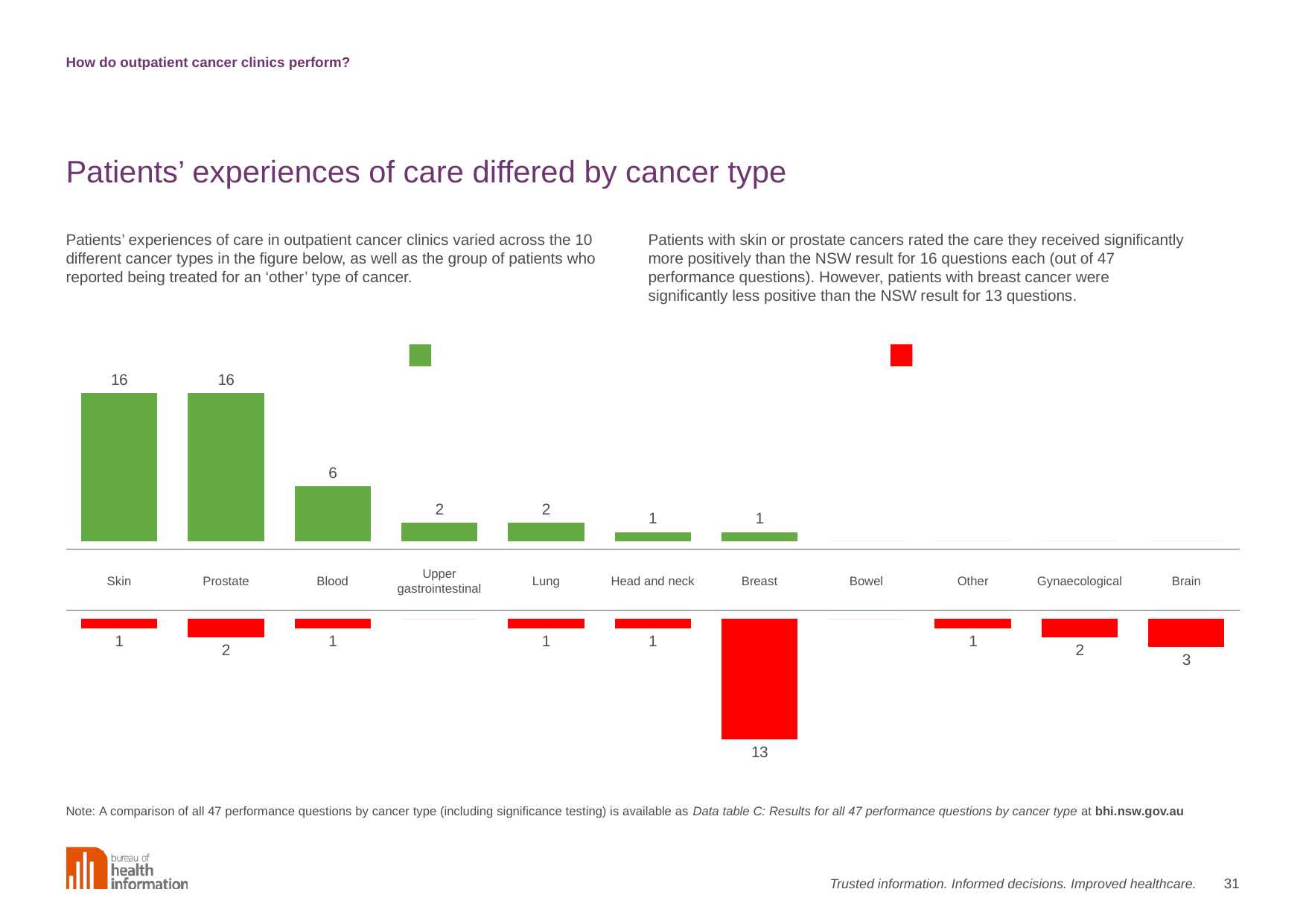
What is the value of the red bar for Breast? 13 Which category has the largest red bar? Breast What kind of chart is shown on the slide? Bar chart What two colours are used for the bars in the chart? Green and red What is the value of the green bar for Skin? 16 What is the difference between the red bar for Breast and the red bar for Brain? 10 Which category has the largest green bar, Blood or Prostate? Prostate What is the difference between the green bar for Skin and the green bar for Blood? 10 What is the value of the green bar for Blood? 6 Is the red bar for Gynaecological larger or smaller than the red bar for Brain? Smaller What is the value of the red bar for Brain? 3 How many categories are shown along the x axis of the chart? 11